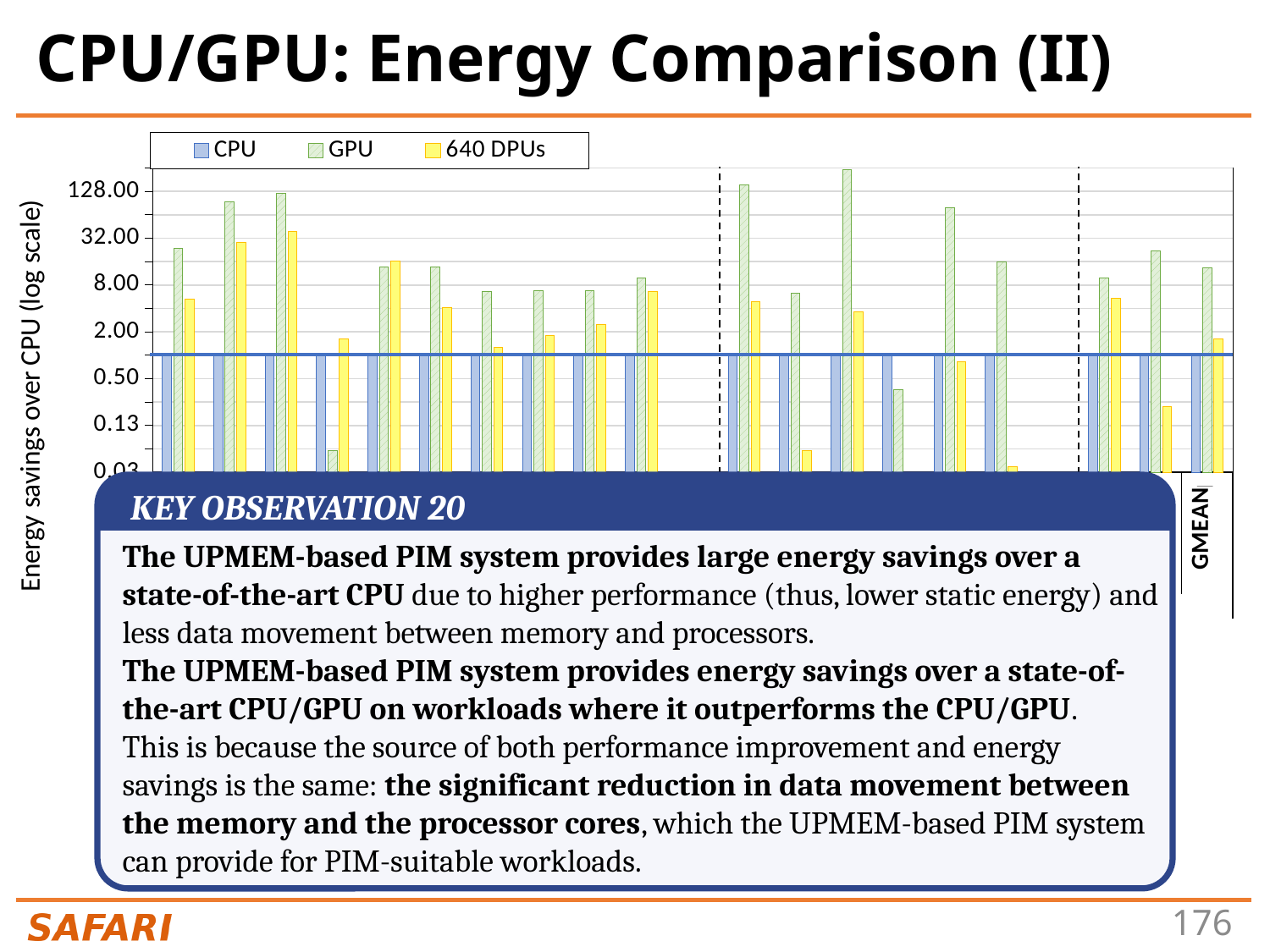
Which series are listed in the chart legend? CPU, GPU, 640 DPUs For GMEAN, is the 640 DPUs value greater or less than 8.00? less What is the highest tick value shown on the y axis? 128.00 For GMEAN, is the GPU value greater or less than 32.00? less What is the label of the y axis? Energy savings over CPU (log scale) For GMEAN, is the GPU value greater or less than 8.00? greater How many series does the legend list? 3 What kind of chart is shown on the slide? bar chart For GMEAN, which is larger: the GPU value or the 640 DPUs value? GPU For GMEAN, which is larger: the 640 DPUs value or the CPU value? 640 DPUs